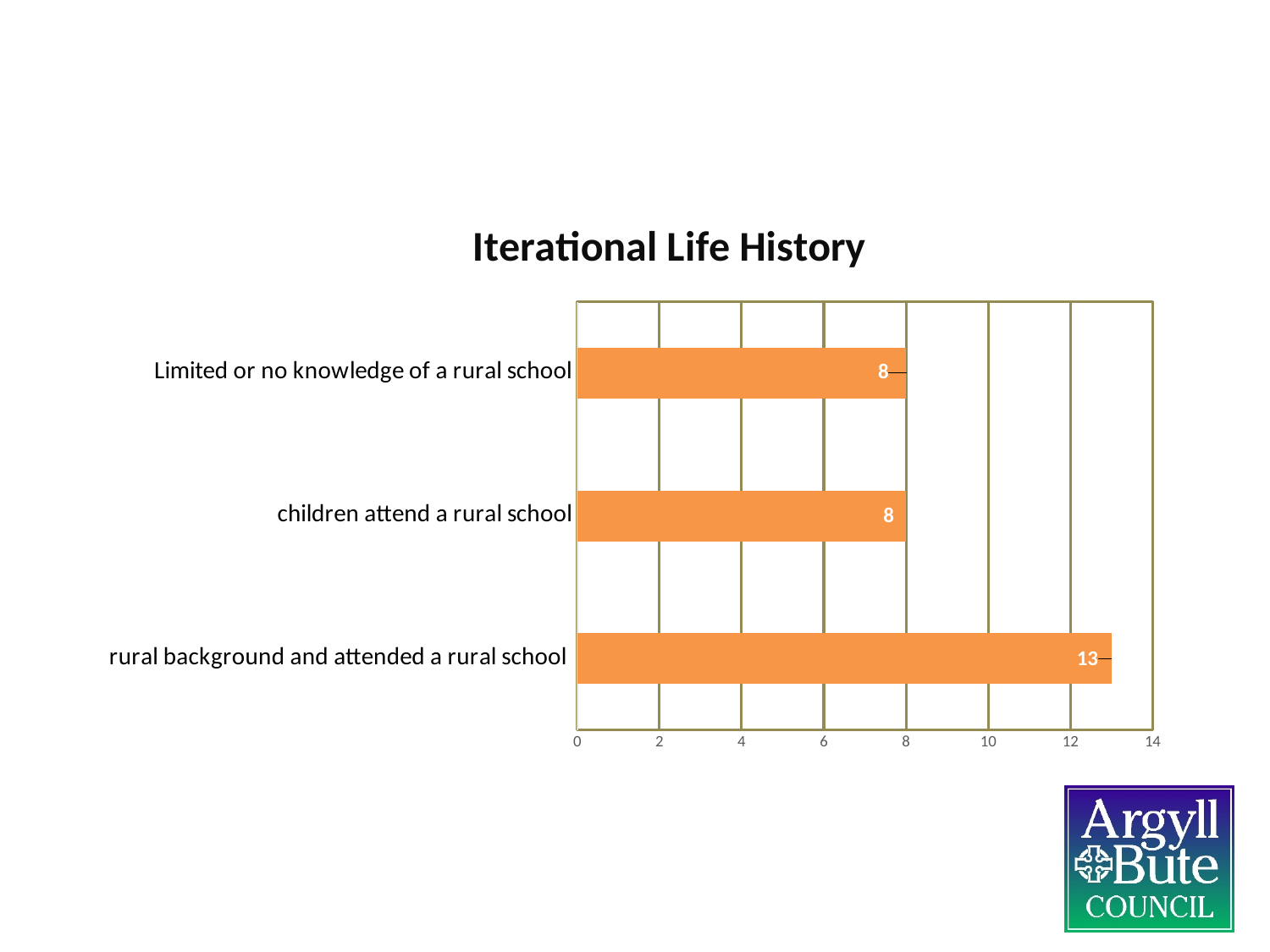
How many categories are shown in the chart? 3 Is the value for "rural background and attended a rural school" greater or less than 10? greater Is the value for "children attend a rural school" greater or less than 10? less What is the value for "children attend a rural school"? 8 What is the value for "Limited or no knowledge of a rural school"? 8 What is the title of the chart? Iterational Life History What is the maximum value shown on the horizontal axis? 14 Which category has the highest value? rural background and attended a rural school Which is larger: the value for "rural background and attended a rural school" or the value for "Limited or no knowledge of a rural school"? rural background and attended a rural school What is the value for "rural background and attended a rural school"? 13 What is the difference between the value for "rural background and attended a rural school" and the value for "children attend a rural school"? 5 What kind of chart is shown on the slide? bar chart